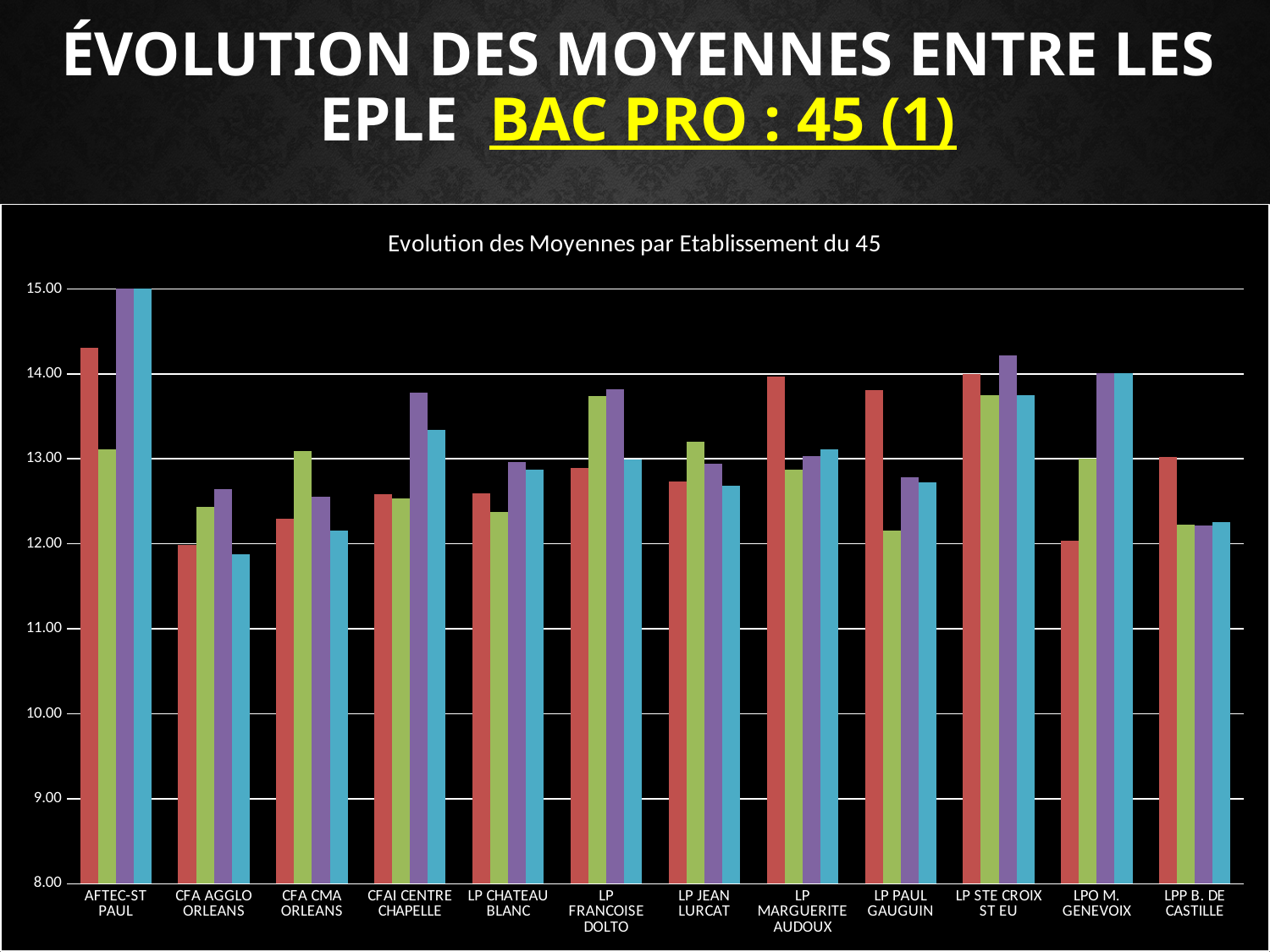
For LP PAUL GAUGUIN, which is larger: the red bar or the green bar? the red bar Which establishment has the highest red bar in the chart? AFTEC-ST PAUL Is the value of the red bar for AFTEC-ST PAUL greater or less than 14.00? greater What is the title of the chart? Evolution des Moyennes par Etablissement du 45 How many establishments (categories) are shown on the x axis of the chart? 12 Is the value of the red bar for LP MARGUERITE AUDOUX greater or less than 13.00? greater What kind of chart is shown on the slide? bar chart Is the value of the purple bar for LP STE CROIX ST EU greater or less than 14.00? greater For CFAI CENTRE CHAPELLE, which is larger: the red bar or the purple bar? the purple bar How many bars are plotted for each establishment in the chart? 4